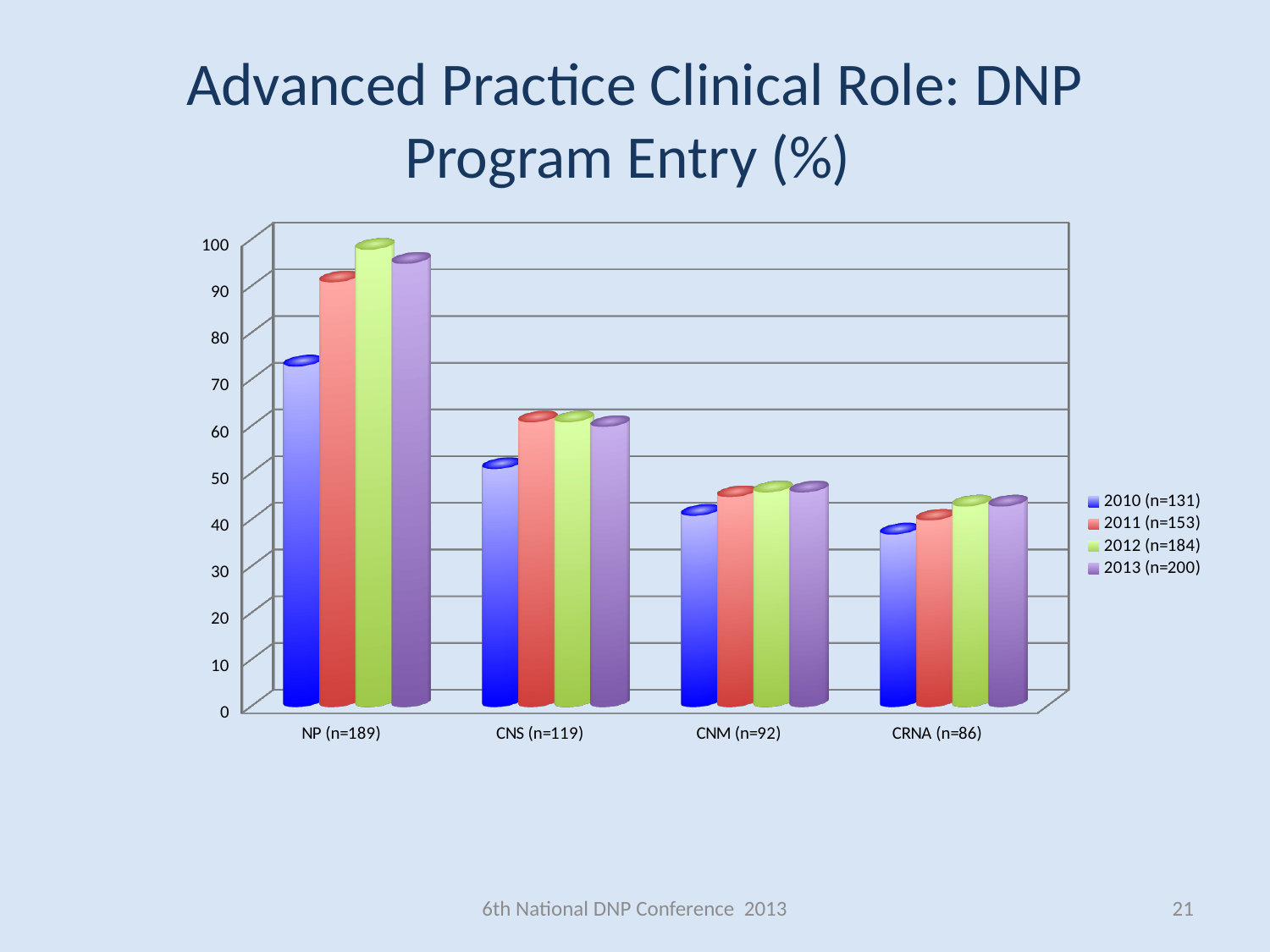
What kind of chart is shown on the slide? bar chart Is the value for NP (n=189) in 2012 (n=184) greater or less than 90? greater Which clinical role has the highest value for 2012 (n=184)? NP (n=189) Moving from NP to CRNA along the x axis, do the values for 2013 (n=200) rise or fall? fall How many categories (clinical roles) are shown on the x axis? 4 What is the title of the chart on the slide? Advanced Practice Clinical Role: DNP Program Entry (%) Which is larger: the 2011 (n=153) value for NP (n=189) or the 2011 (n=153) value for CNS (n=119)? NP (n=189) Is the value for CNS (n=119) in 2010 (n=131) greater or less than 40? greater Which clinical role has the lowest value for 2010 (n=131)? CRNA (n=86) Is the value for NP (n=189) in 2010 (n=131) greater or less than 80? less How many series does the legend list? 4